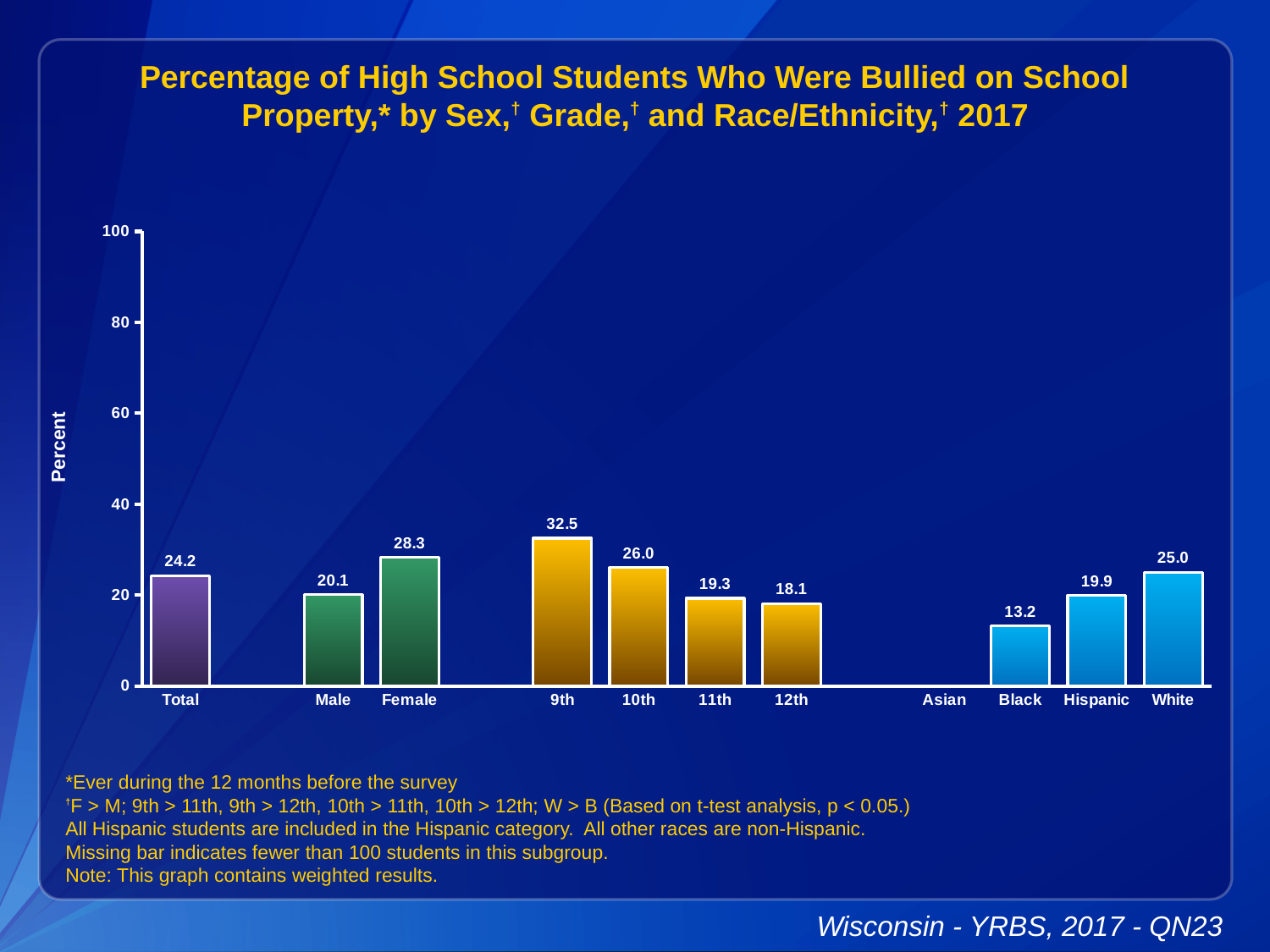
What is the value for Female? 28.3 What is the value for Total? 24.2 Which is larger, the value for White or the value for Hispanic? White Is the value for 12th grade greater or less than 20? less How many categories have a bar plotted? 10 Which category has no bar shown? Asian What is the value for Black students? 13.2 Which category with a bar has the lowest value? Black Which category has the highest value? 9th What kind of chart is shown? Bar chart What is the value for 9th grade? 32.5 What is the difference between the Female and Male values? 8.2